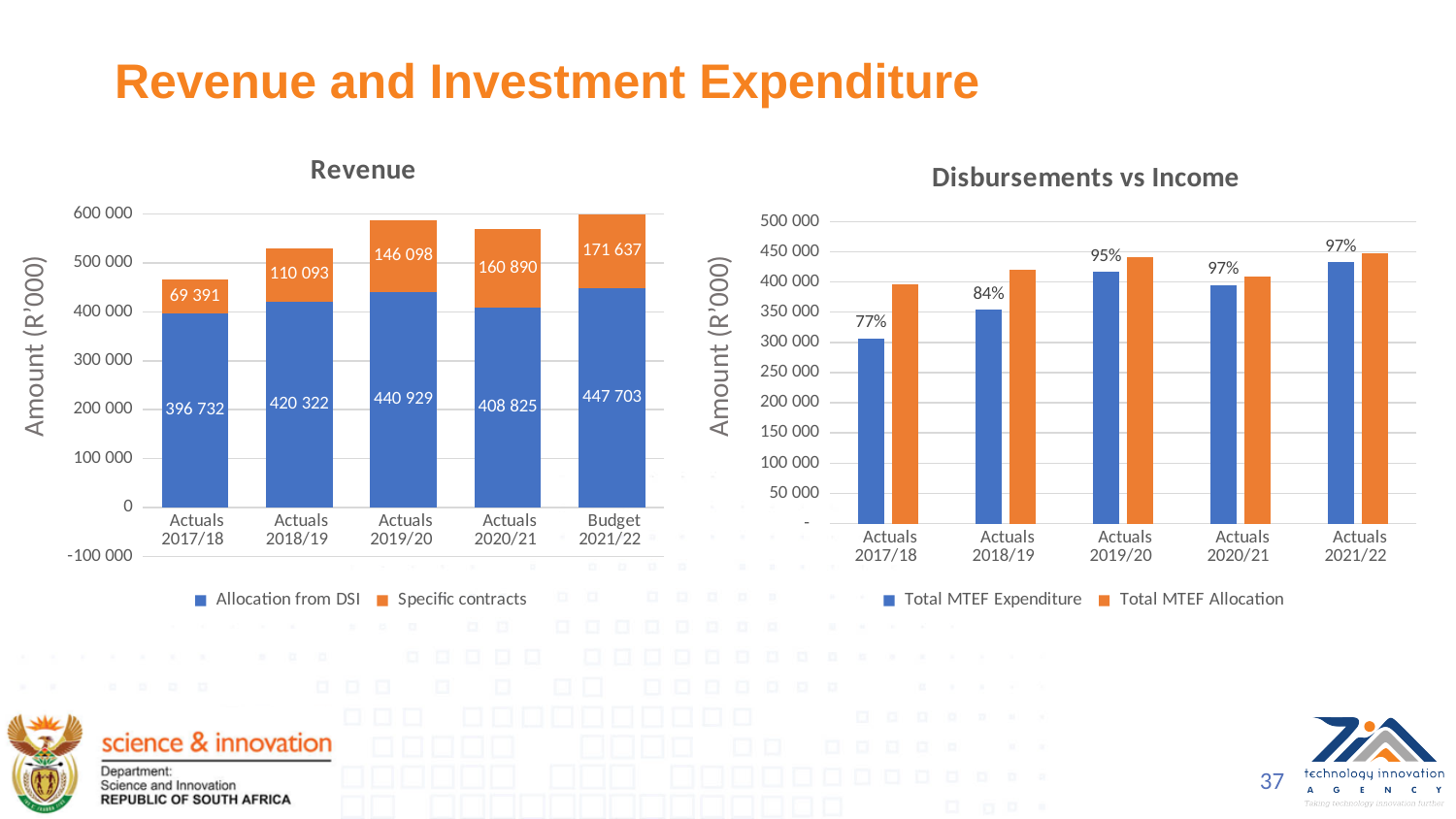
In the Revenue chart, which period has the lowest Specific contracts value? Actuals 2017/18 In the Revenue chart, which period has the highest Allocation from DSI value? Budget 2021/22 In the Revenue chart, how many series does the legend list? 2 In the Disbursements vs Income chart, what percentage is shown for Actuals 2017/18? 77% In the Revenue chart, what is the Allocation from DSI value for Actuals 2019/20? 440 929 In the Disbursements vs Income chart, is the Total MTEF Expenditure value for Actuals 2017/18 greater or less than 350 000? less In the Disbursements vs Income chart, how many periods are shown on the x axis? 5 In the Revenue chart, does the Specific contracts value rise or fall from Actuals 2017/18 to Budget 2021/22? rise In the Revenue chart, what is the total of the stacked bar for Actuals 2018/19? 530 415 What kind of chart is the Disbursements vs Income chart? bar chart In the Revenue chart, what is the Specific contracts value for Budget 2021/22? 171 637 In the Revenue chart, what is the difference between the Specific contracts values for Actuals 2020/21 and Actuals 2019/20? 14 792